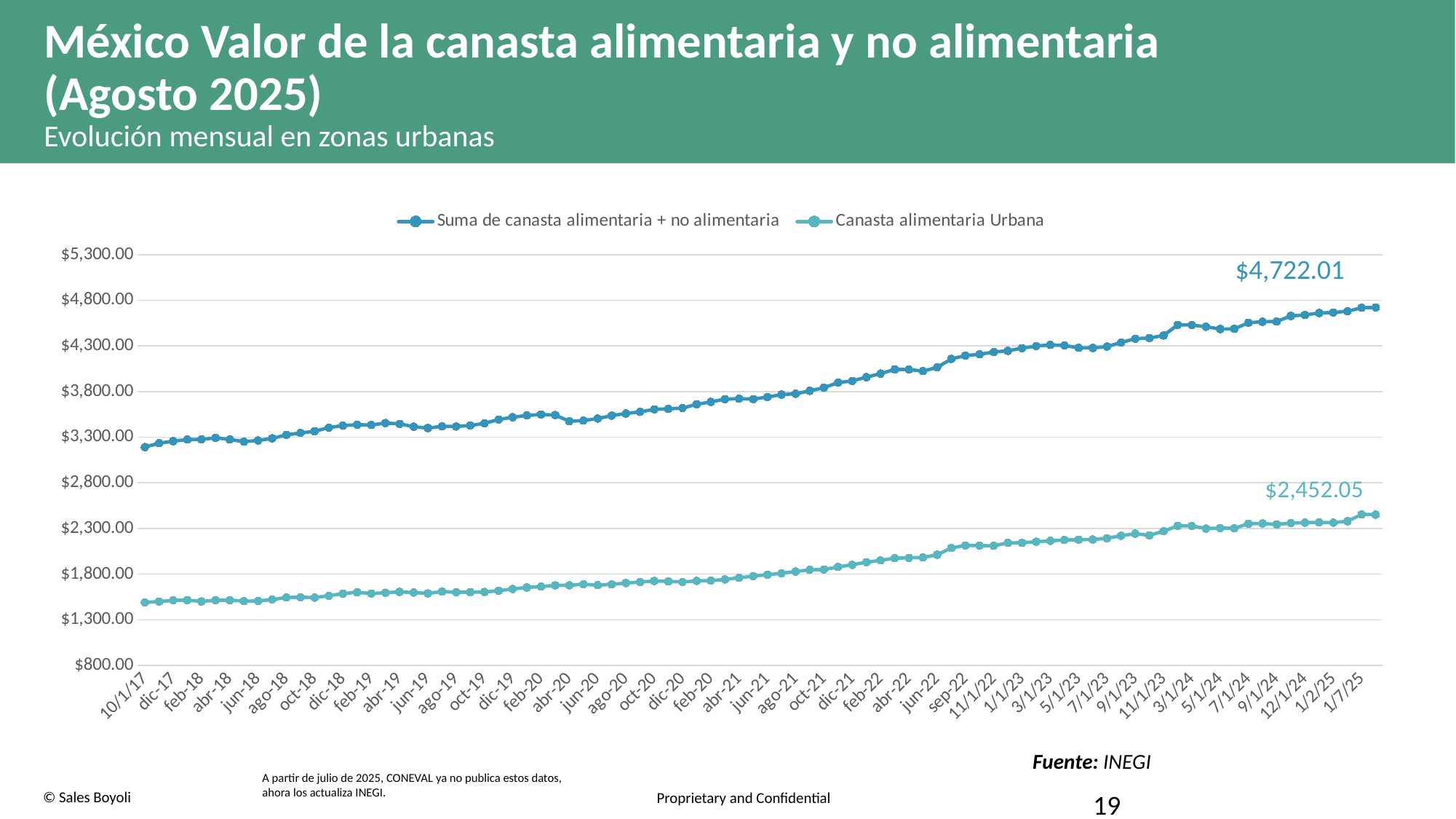
Do the values of both series generally rise or fall from left to right along the x axis? rise What is the labelled value of the 'Canasta alimentaria Urbana' series at the end of the chart? $2,452.05 Is the value of 'Canasta alimentaria Urbana' at 10/1/17 greater or less than $1,800.00? less Is the value of 'Suma de canasta alimentaria + no alimentaria' at 10/1/17 greater or less than $3,300.00? less How many series does the legend list? 2 What is the labelled value of the 'Suma de canasta alimentaria + no alimentaria' series at the end of the chart? $4,722.01 Is the value of 'Suma de canasta alimentaria + no alimentaria' at 1/7/25 greater or less than $4,300.00? greater What is the difference between the two labelled values, $4,722.01 and $2,452.05? $2,269.96 What is the first date label shown on the x axis? 10/1/17 What kind of chart is shown on the slide? line chart Which series has the higher values throughout the chart? Suma de canasta alimentaria + no alimentaria What is the subtitle shown below the main title of the slide? Evolución mensual en zonas urbanas